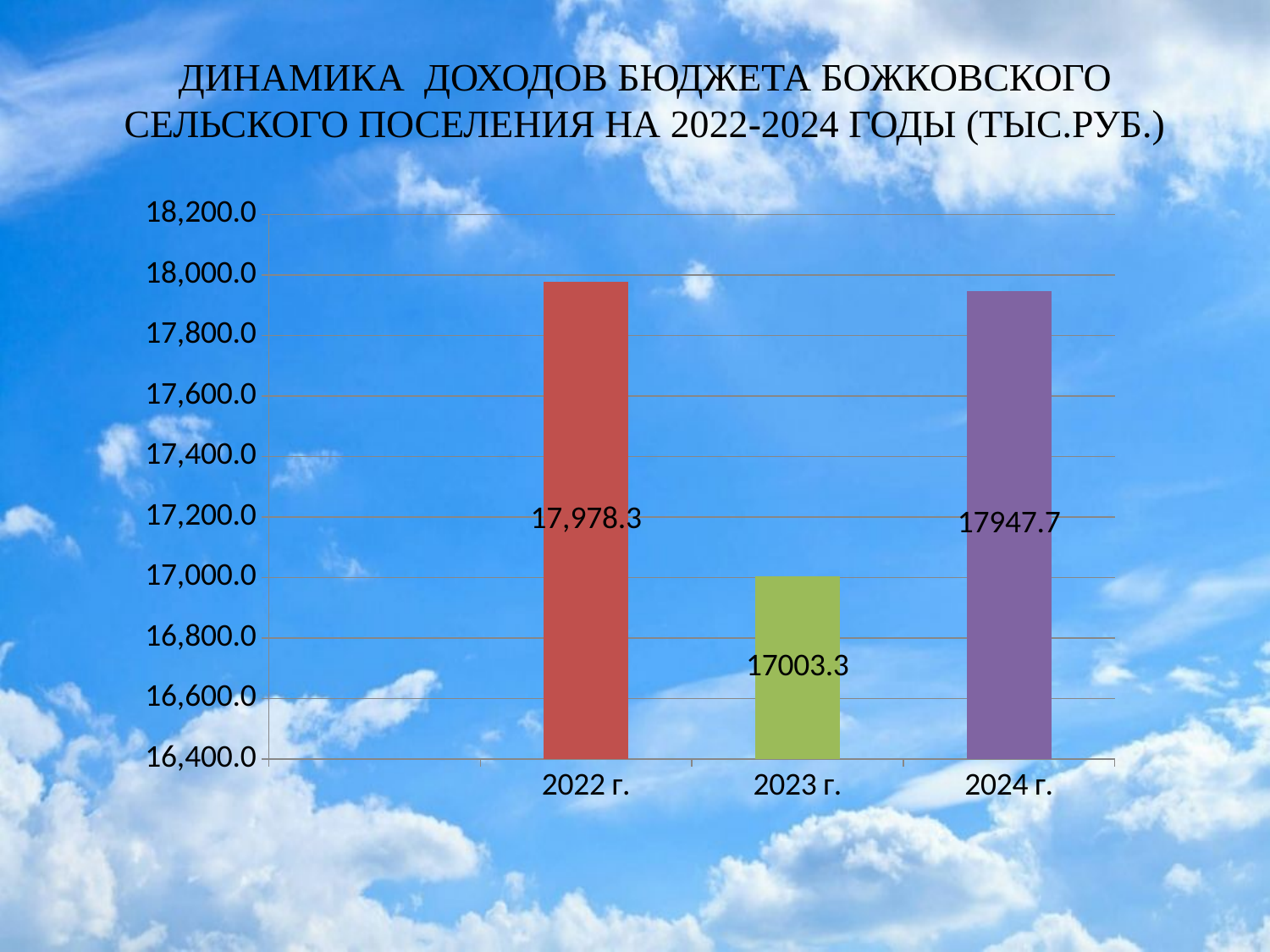
Does the value rise or fall from 2022 г. to 2023 г.? fall Which year has the highest budget revenue on the chart? 2022 г. Is the value for 2023 г. greater or less than 17,200.0? less How many years are shown on the chart? 3 What is the budget revenue value shown for 2023 г.? 17003.3 What is the difference between the values for 2024 г. and 2023 г.? 944.4 What is the budget revenue value shown for 2024 г.? 17947.7 What is the difference between the values for 2022 г. and 2023 г.? 975.0 What kind of chart is shown on the slide? bar chart Which year has the lowest budget revenue on the chart? 2023 г. Which is larger, the value for 2022 г. or the value for 2024 г.? 2022 г. What is the budget revenue value shown for 2022 г.? 17,978.3